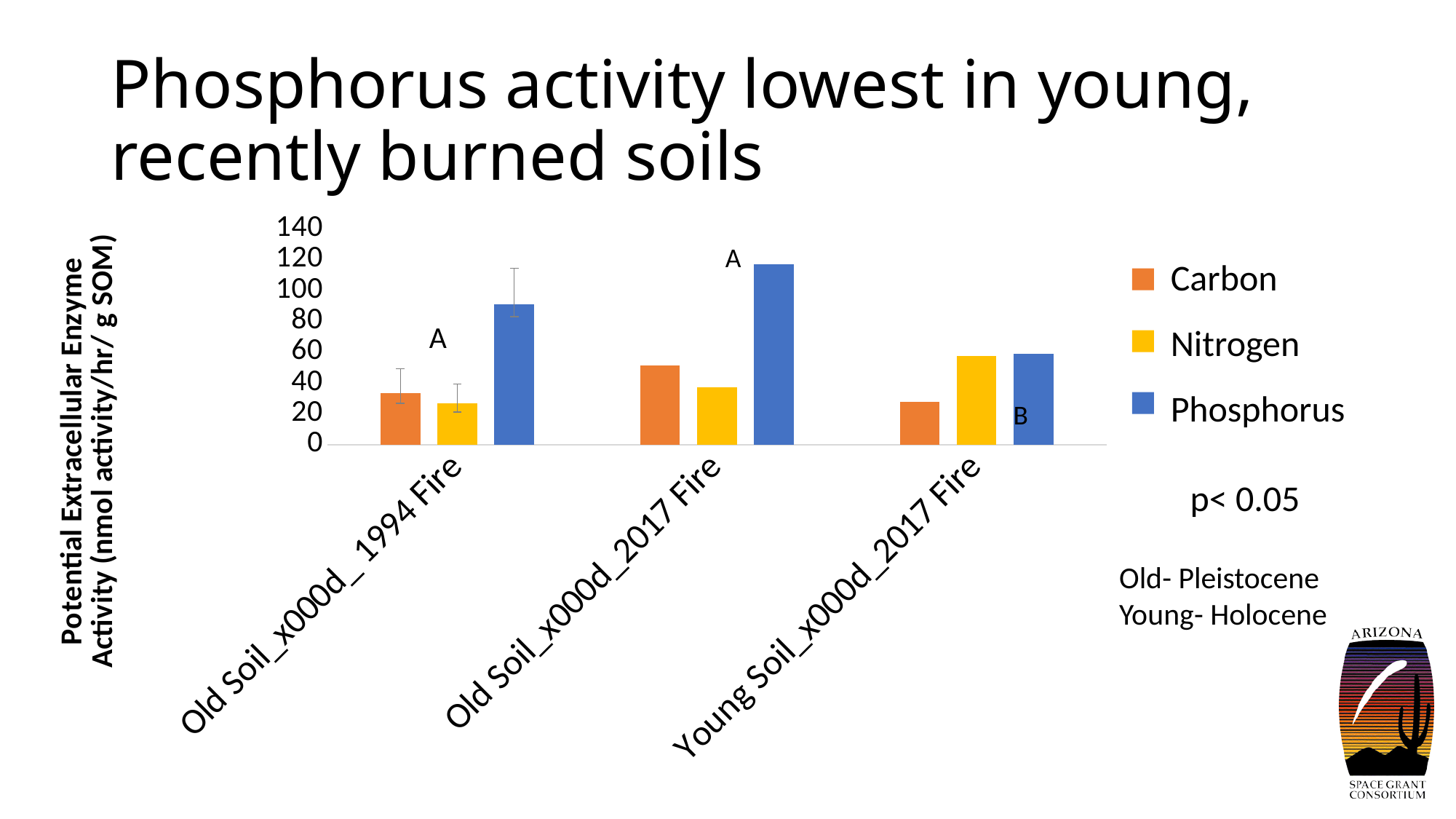
Which is larger: the Nitrogen value for Young Soil 2017 Fire or the Nitrogen value for Old Soil 1994 Fire? Young Soil 2017 Fire Which colour represents Phosphorus in the legend? blue Is the Phosphorus value for Young Soil 2017 Fire greater or less than 80? less Is the Carbon value for Young Soil 2017 Fire greater or less than 40? less Which is larger: the Carbon value for Old Soil 2017 Fire or the Carbon value for Young Soil 2017 Fire? Old Soil 2017 Fire In which category is the Phosphorus bar highest? Old Soil 2017 Fire In which category is the Phosphorus bar lowest? Young Soil 2017 Fire Is the Phosphorus value for Old Soil 2017 Fire greater or less than 100? greater How many soil/fire categories are shown along the x axis? 3 What kind of chart is shown on the slide? bar chart How many series does the chart legend list? 3